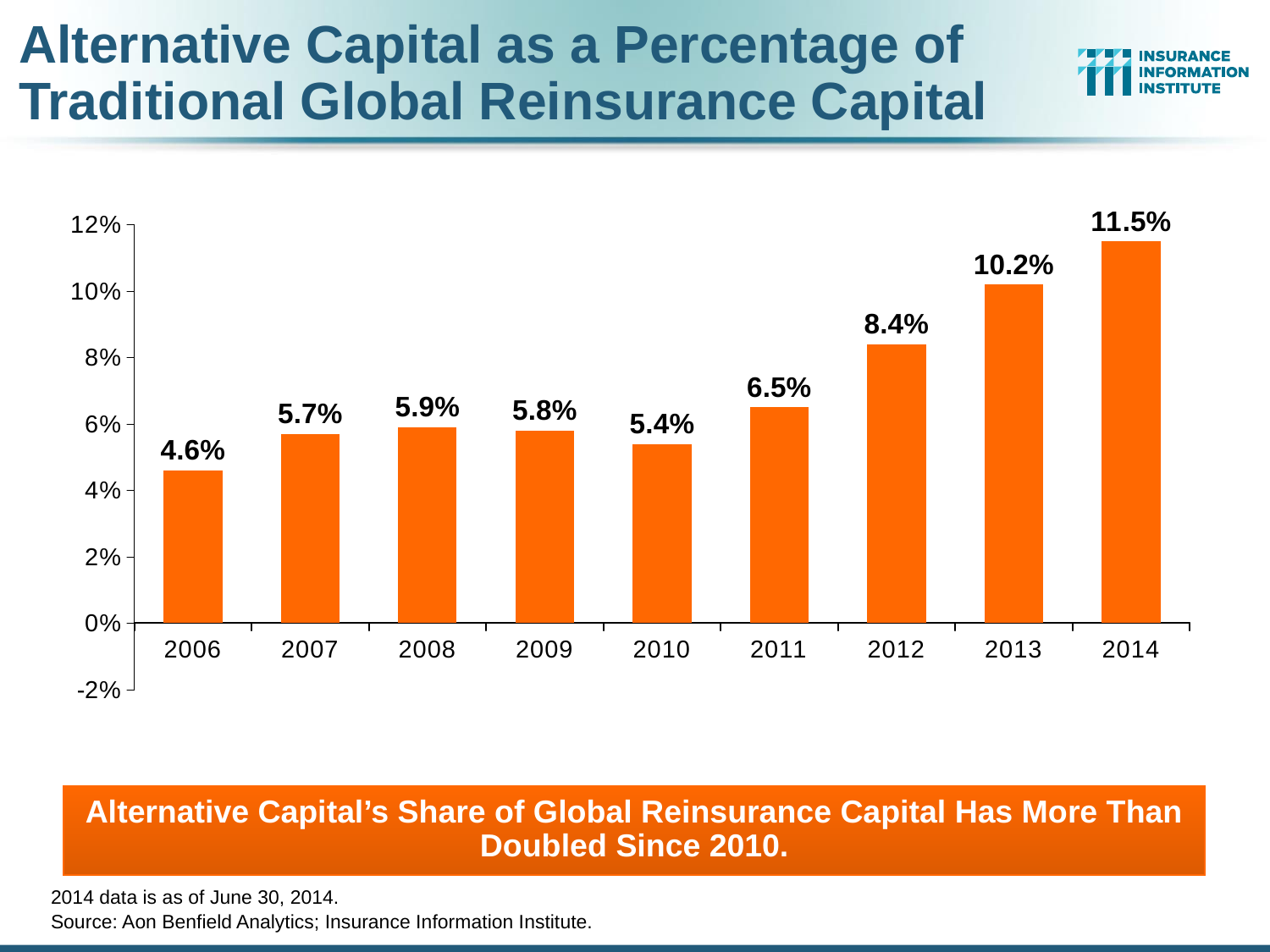
Do the values rise or fall from 2010 to 2014? Rise What is the value for 2010? 5.4% Which is larger, the value for 2008 or the value for 2011? 2011 What kind of chart is shown on the slide? Bar chart How many years are shown on the x axis? 9 What is the difference between the values for 2013 and 2012? 1.8% What is the value for 2014? 11.5% Is the value for 2012 greater or less than 8%? greater What is the value for 2006? 4.6% Which year has the highest value? 2014 Which year has the lowest value? 2006 What is the difference between the values for 2014 and 2010? 6.1%